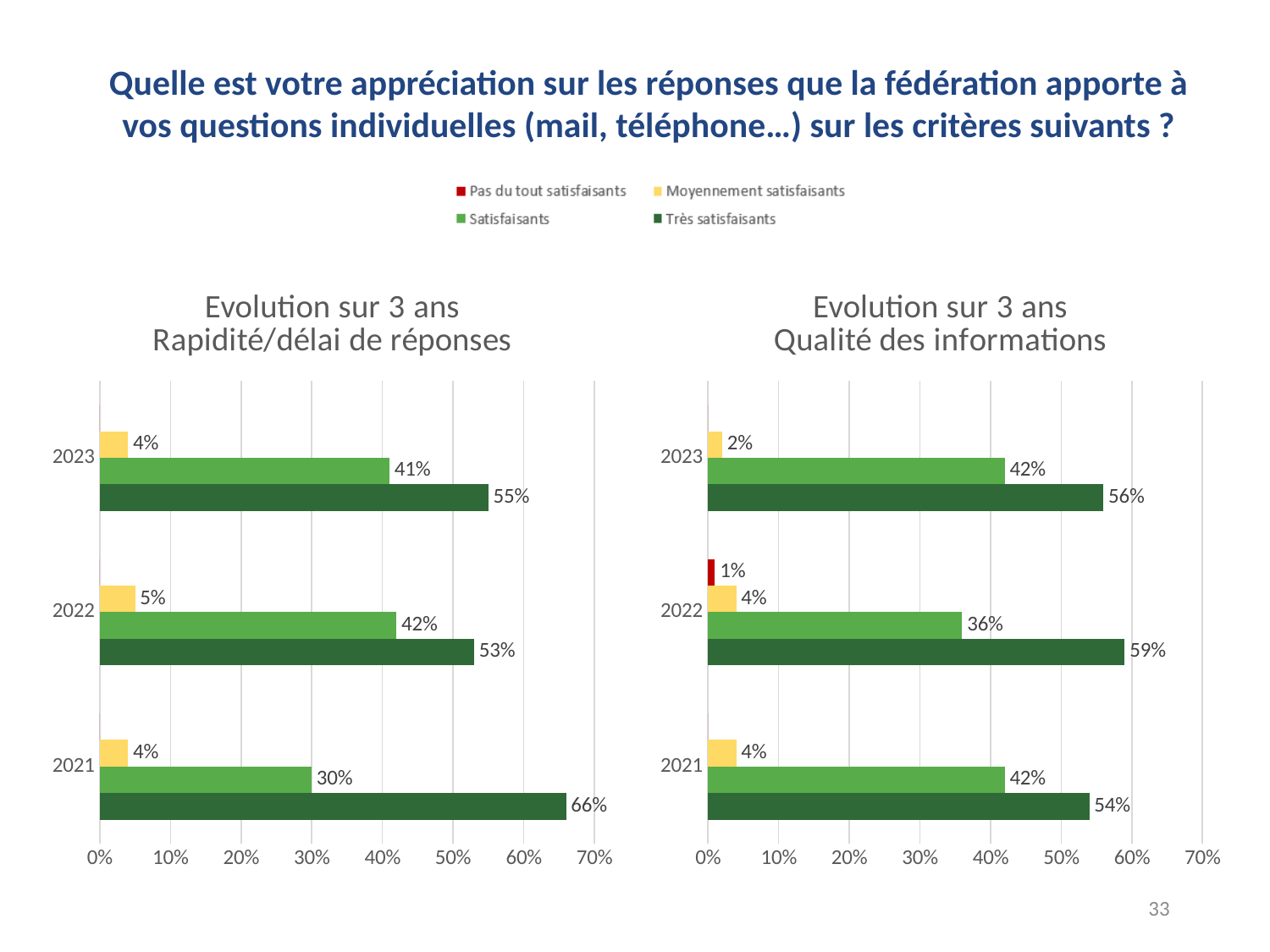
In the 'Qualité des informations' chart, what is the value for 'Pas du tout satisfaisants' in 2022? 1% How many series does the legend list? 4 In the 'Qualité des informations' chart, what is the difference between 'Très satisfaisants' and 'Satisfaisants' in 2022? 23% What type of chart is the 'Qualité des informations' chart? Bar chart In the 'Qualité des informations' chart, is the value for 'Très satisfaisants' in 2022 greater or less than 50%? greater In the 'Qualité des informations' chart, what is the value for 'Satisfaisants' in 2022? 36% In the 'Rapidité/délai de réponses' chart, what is the value for 'Moyennement satisfaisants' in 2022? 5% In the 'Rapidité/délai de réponses' chart, which year has the highest value for 'Très satisfaisants'? 2021 In the 'Rapidité/délai de réponses' chart, what is the value for 'Très satisfaisants' in 2021? 66% In the 'Rapidité/délai de réponses' chart, is the value for 'Très satisfaisants' in 2023 larger than in 2022? Yes In the 'Rapidité/délai de réponses' chart, which year has the lowest value for 'Satisfaisants'? 2021 How many years are shown in the 'Rapidité/délai de réponses' chart? 3